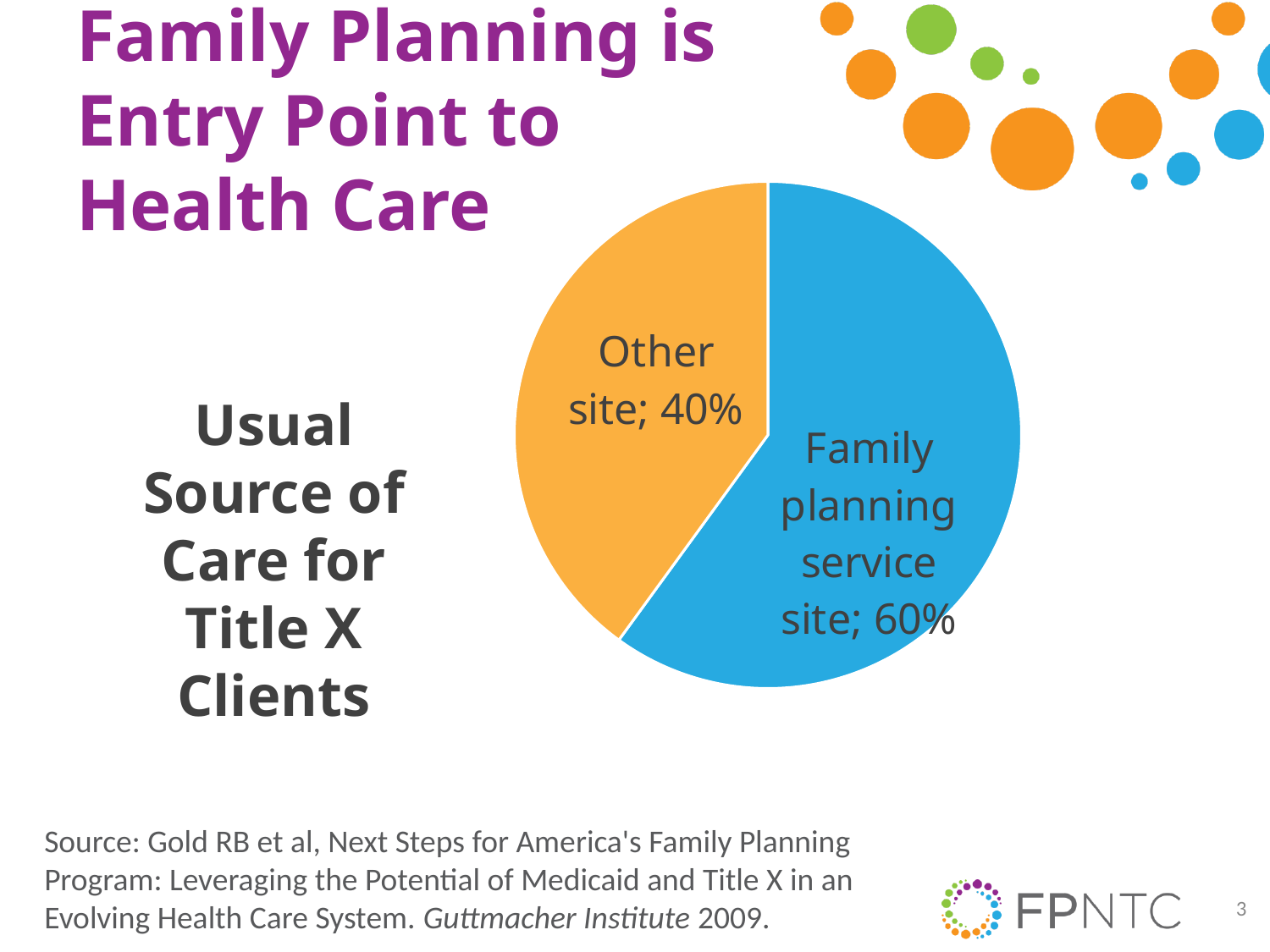
Which is larger: the share for family planning service site or the share for other site? Family planning service site What is the difference in percentage points between the family planning service site slice and the other site slice? 20 percentage points What is the total of the two slices shown in the pie chart? 100% Which slice of the pie is the largest? Family planning service site What colour is the family planning service site slice? blue What share of Title X clients have a family planning service site as their usual source of care? 60% What kind of chart is shown on the slide? pie chart How many slices does the pie chart have? 2 Is the share for other site greater or less than 50%? less Which slice of the pie is the smallest? Other site What share of Title X clients have an other site as their usual source of care? 40% What is the title of the pie chart? Usual Source of Care for Title X Clients